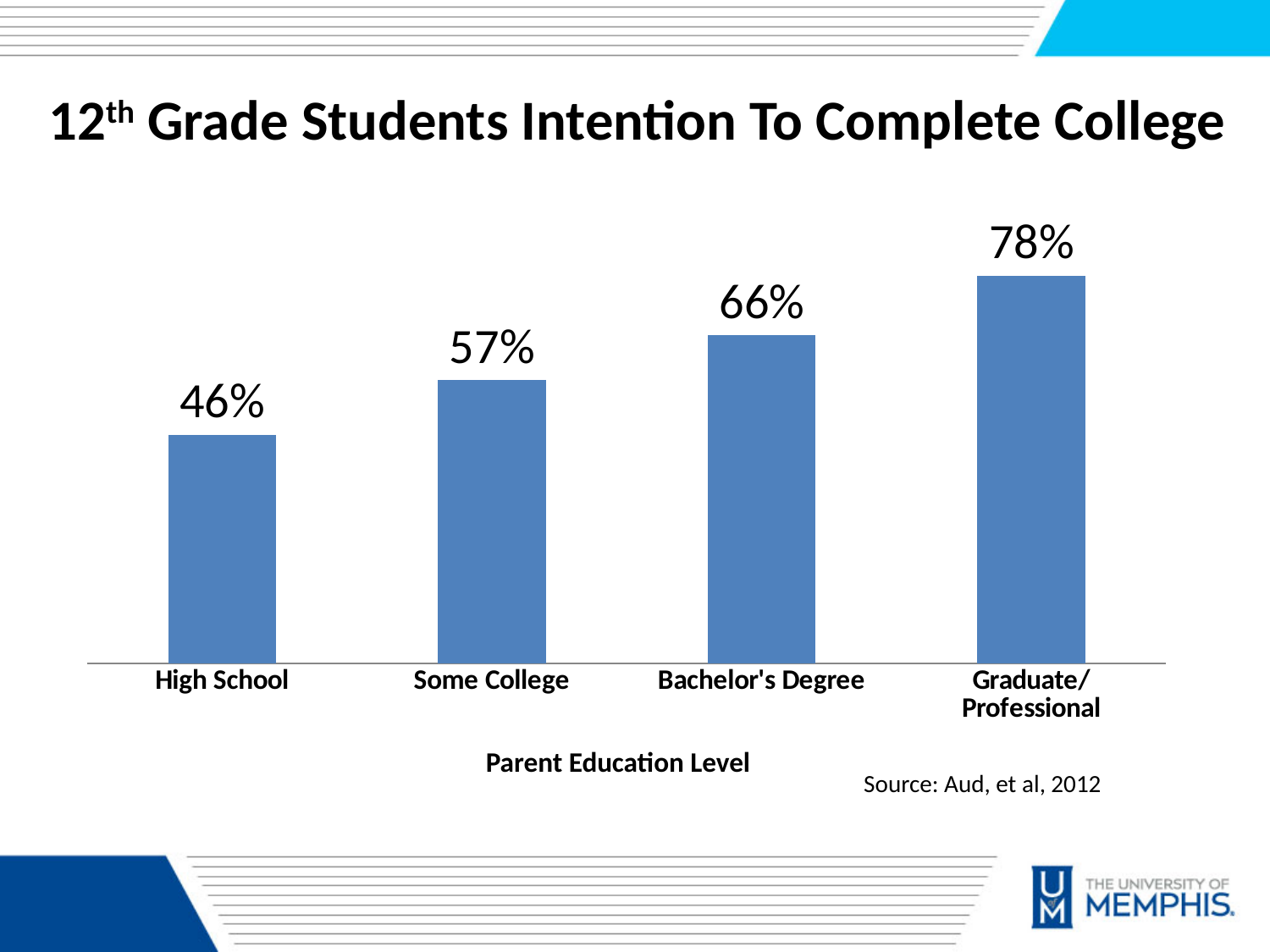
What is the difference between the values for Graduate/Professional and High School? 32% How many parent education levels are shown on the chart? 4 What is the difference between the values for Bachelor's Degree and Some College? 9% What is the value for Graduate/Professional? 78% What is the value for Bachelor's Degree? 66% Which parent education level has the highest value? Graduate/Professional Which is larger, the value for Some College or the value for Bachelor's Degree? Bachelor's Degree What is the value for High School? 46% Which parent education level has the lowest value? High School What is the value for Some College? 57% What kind of chart is shown on the slide? Bar chart Do the values rise or fall from High School to Graduate/Professional? Rise